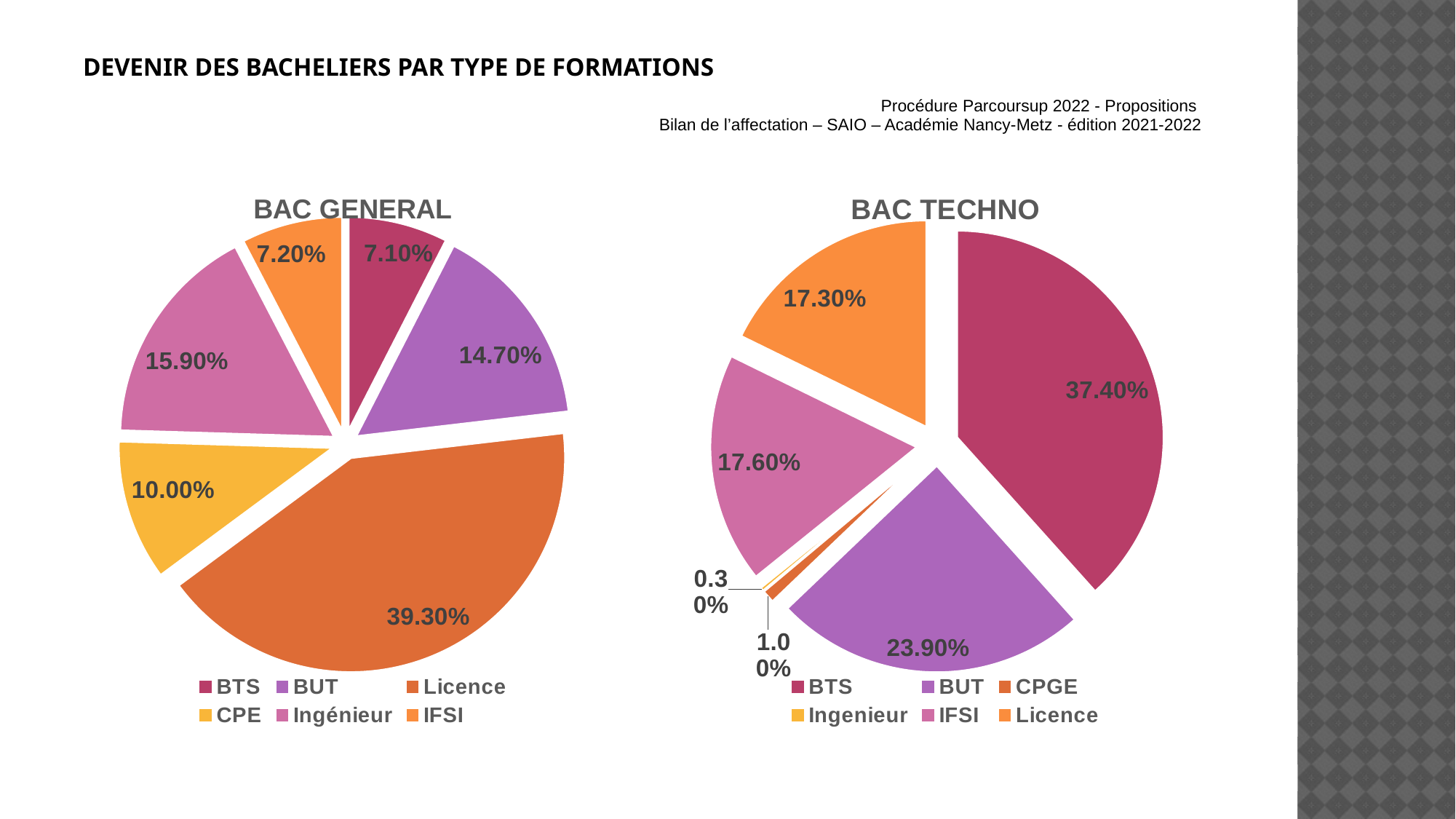
In the BAC GENERAL chart, what share does Licence have? 39.30% What type of chart is the BAC GENERAL chart? Pie chart In the BAC GENERAL chart, which category has the largest share? Licence In the BAC GENERAL chart, what is the value for Ingénieur? 15.90% What is the title of the chart on the right side of the slide? BAC TECHNO In the BAC GENERAL chart, which category has the smallest share? BTS In the BAC GENERAL chart, what is the difference between the BUT and CPE values? 4.70% In the BAC TECHNO chart, what is the value for IFSI? 17.60% In the BAC TECHNO chart, which is larger, BUT or Licence? BUT How many categories does the legend of the BAC TECHNO chart list? 6 In the BAC TECHNO chart, which category has the largest share? BTS In the BAC TECHNO chart, what is the value for BTS? 37.40%